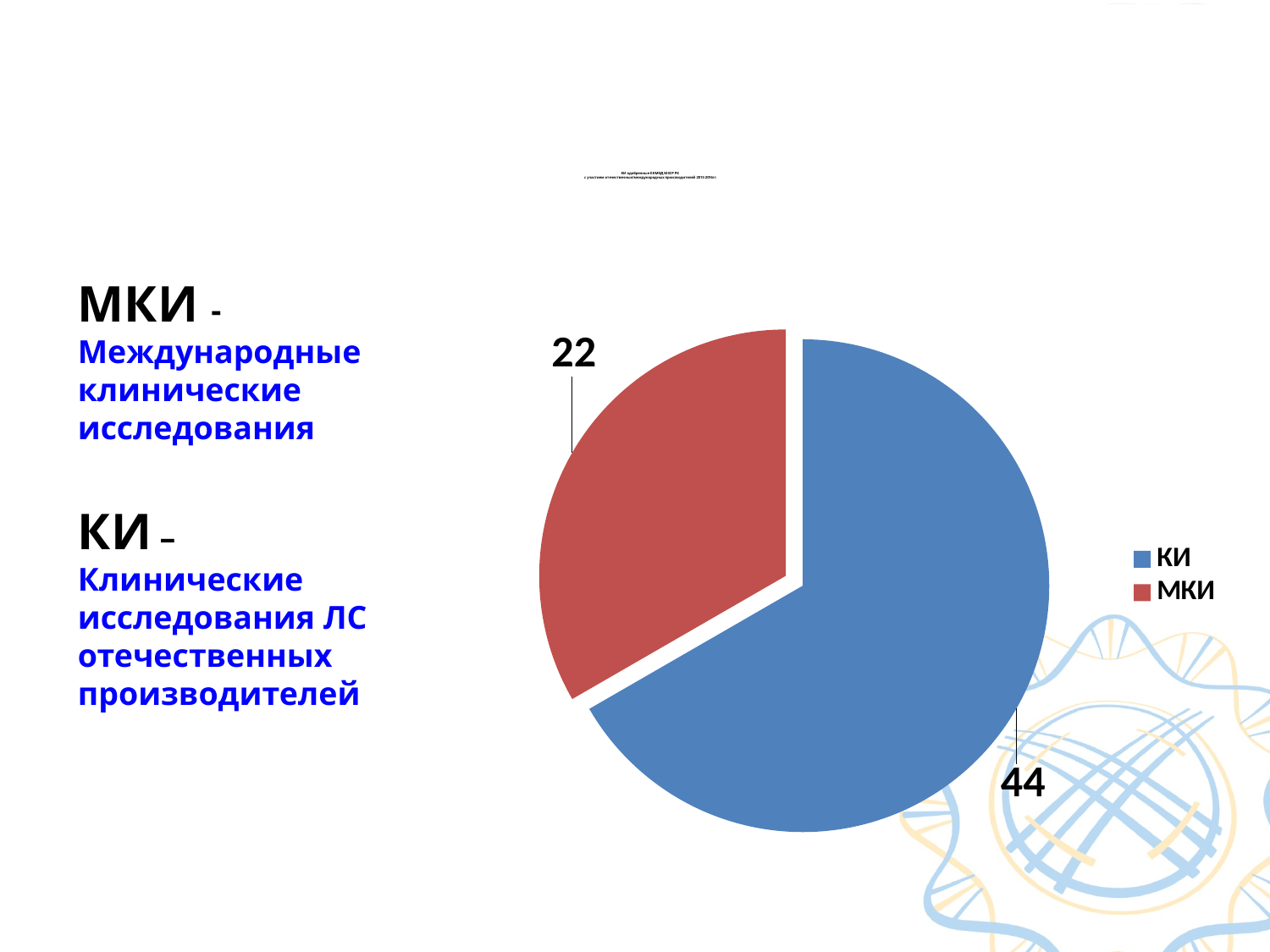
What is the value for МКИ in the pie chart? 22 What share of the pie does the КИ slice represent? two thirds How many slices does the pie chart have? 2 What is the total of the two values shown in the pie chart? 66 How many entries does the legend list? 2 Which category has the smallest slice in the pie chart? МКИ What is the difference between the values for КИ and МКИ? 22 What type of chart is shown on the slide? pie chart What colour is the МКИ slice in the pie chart? red Which category has the largest slice in the pie chart? КИ What is the value for КИ in the pie chart? 44 Which is larger, the value for КИ or the value for МКИ? КИ